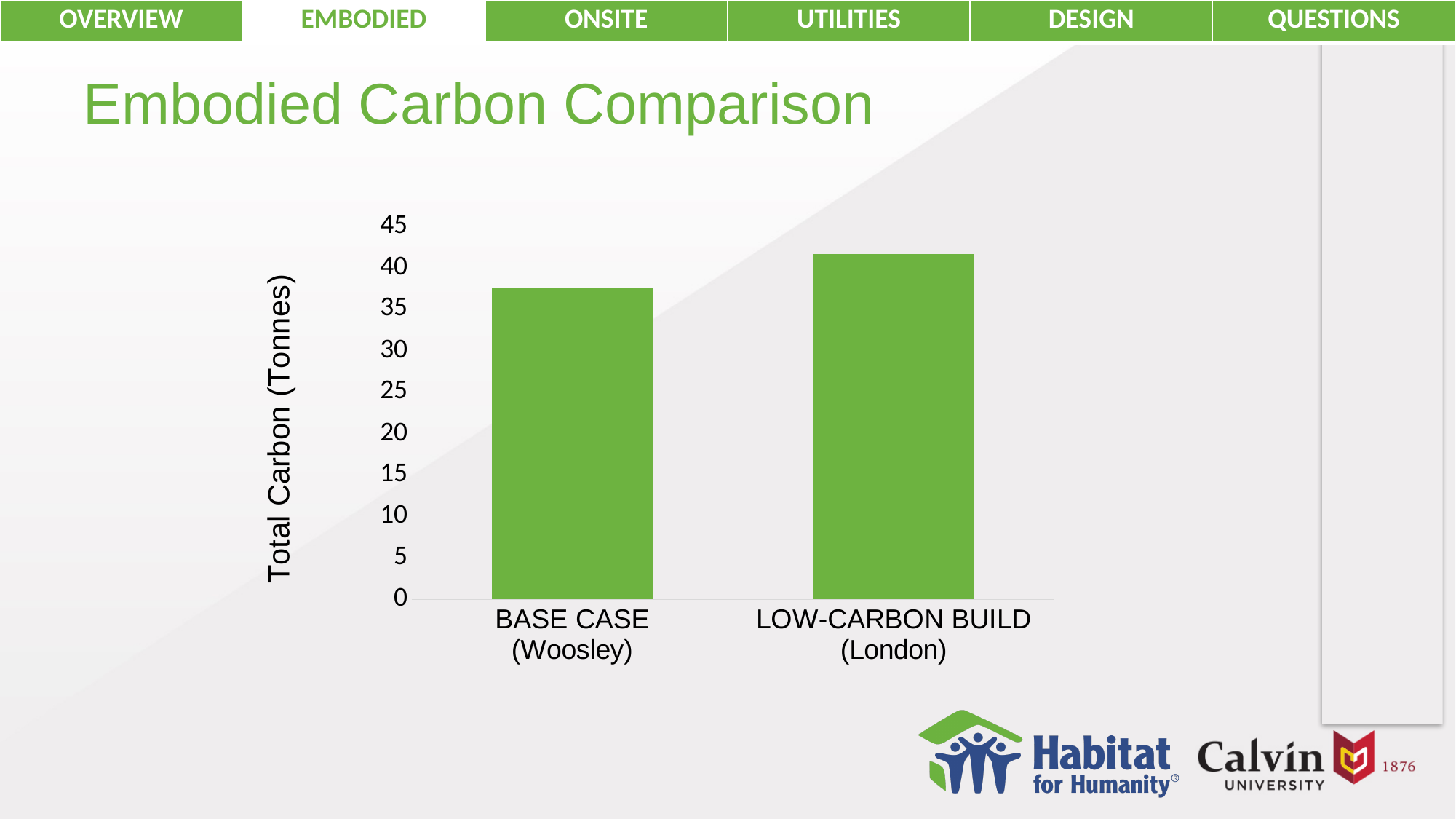
What is the title of the chart's vertical axis? Total Carbon (Tonnes) Is the value for BASE CASE (Woosley) greater or less than 40? less Is the value for BASE CASE (Woosley) greater or less than 35? greater Is the value for LOW-CARBON BUILD (London) greater or less than 45? less What kind of chart is shown on the slide? bar chart Which category has the highest total carbon? LOW-CARBON BUILD (London) How many categories are plotted in the chart? 2 Which category has the lowest total carbon? BASE CASE (Woosley) What is the highest value shown on the vertical axis? 45 Which is larger, the value for BASE CASE (Woosley) or the value for LOW-CARBON BUILD (London)? LOW-CARBON BUILD (London) What is the title shown above the chart? Embodied Carbon Comparison